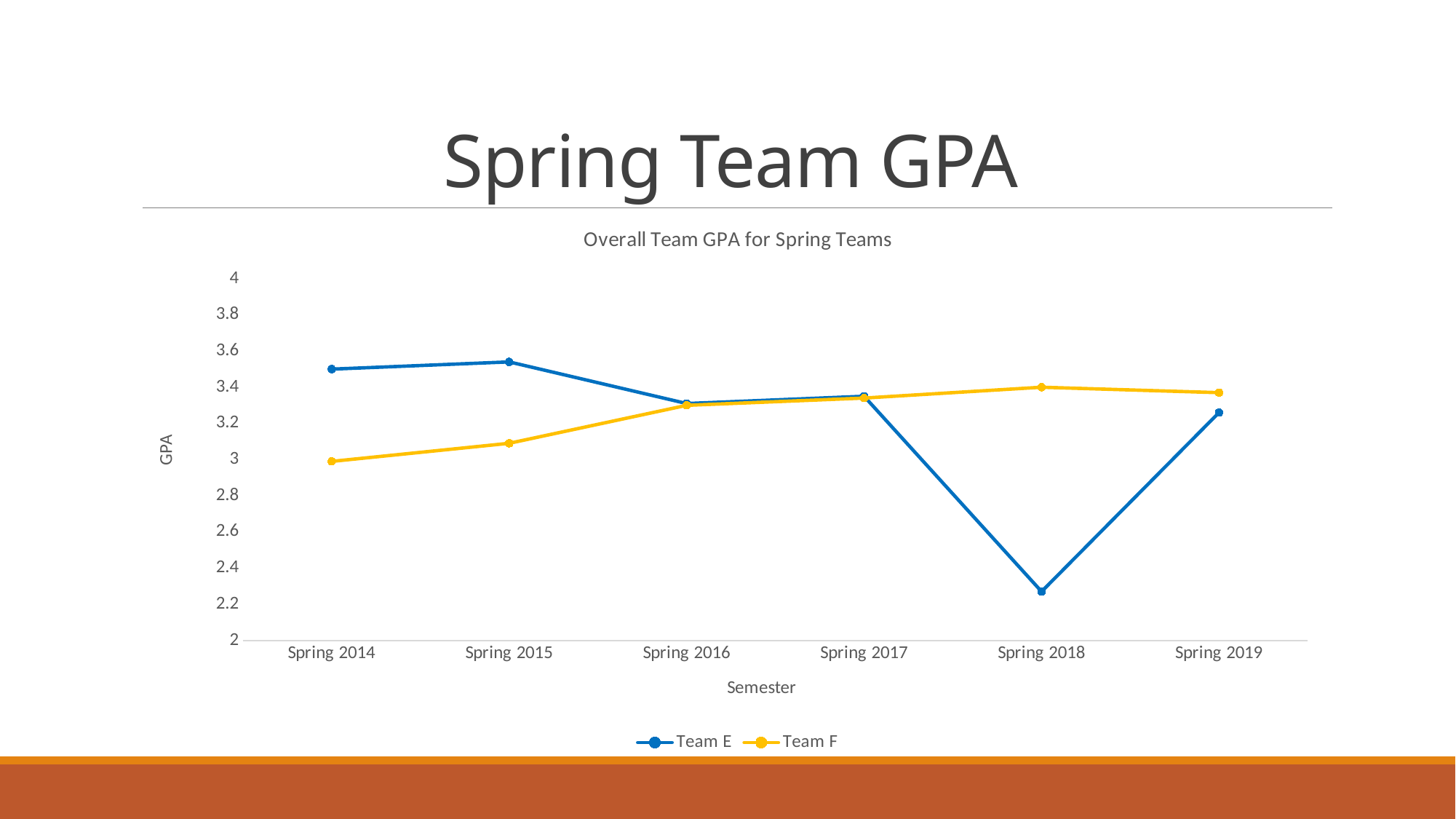
In which semester does Team E have its lowest GPA? Spring 2018 In Spring 2014, which team has the higher GPA, Team E or Team F? Team E What kind of chart is shown on the slide? Line chart How many series does the legend list? 2 What is the title of the chart? Overall Team GPA for Spring Teams Is the value for Team E in Spring 2018 greater or less than 2.4? less Is the value for Team E in Spring 2015 greater or less than 3.4? greater In which semester does Team F have its lowest GPA? Spring 2014 How many semesters are plotted along the x axis? 6 In Spring 2018, which team has the higher GPA, Team E or Team F? Team F Is the value for Team F in Spring 2014 greater or less than 3.2? less Does Team F's GPA rise or fall from Spring 2014 to Spring 2016? Rise